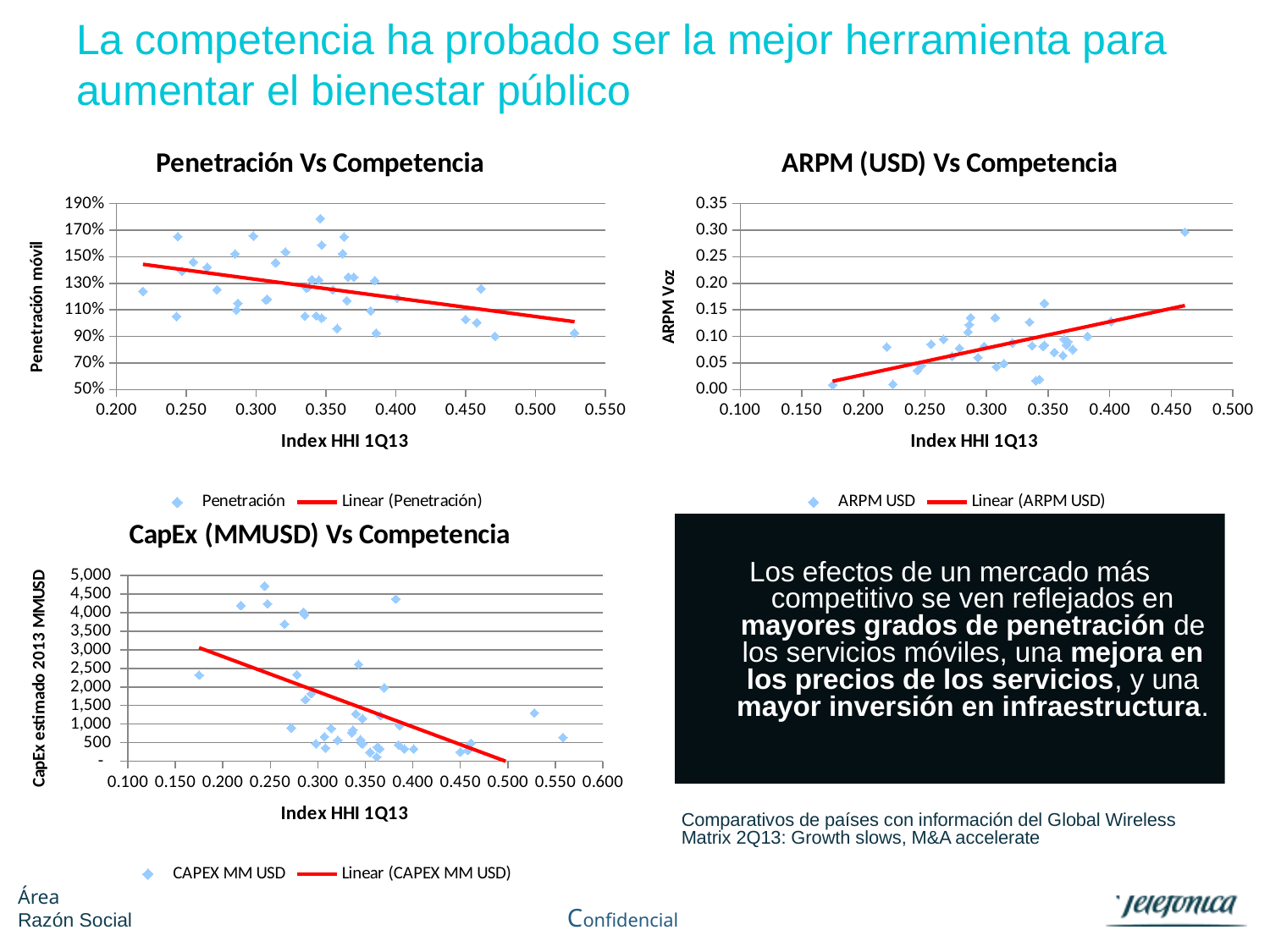
What are the two legend entries of the "CapEx (MMUSD) Vs Competencia" chart? CAPEX MM USD and Linear (CAPEX MM USD) In the "CapEx (MMUSD) Vs Competencia" chart, does the red trend line rise or fall as Index HHI 1Q13 increases? Falls What kind of chart is the "Penetración Vs Competencia" chart? Scatter chart How many entries does the legend of the "Penetración Vs Competencia" chart list? 2 In the "Penetración Vs Competencia" chart, does the red trend line rise or fall as Index HHI 1Q13 increases? Falls How many entries does the legend of the "ARPM (USD) Vs Competencia" chart list? 2 What kind of chart is the "CapEx (MMUSD) Vs Competencia" chart? Scatter chart How many charts are shown on the slide? 3 In the "ARPM (USD) Vs Competencia" chart, does the red trend line rise or fall as Index HHI 1Q13 increases? Rises In the "CapEx (MMUSD) Vs Competencia" chart, is the highest plotted CapEx value greater or less than 4,000? greater In the "Penetración Vs Competencia" chart, is the highest plotted penetration value greater or less than 170%? greater In the "ARPM (USD) Vs Competencia" chart, is the highest plotted ARPM value greater or less than 0.25? greater